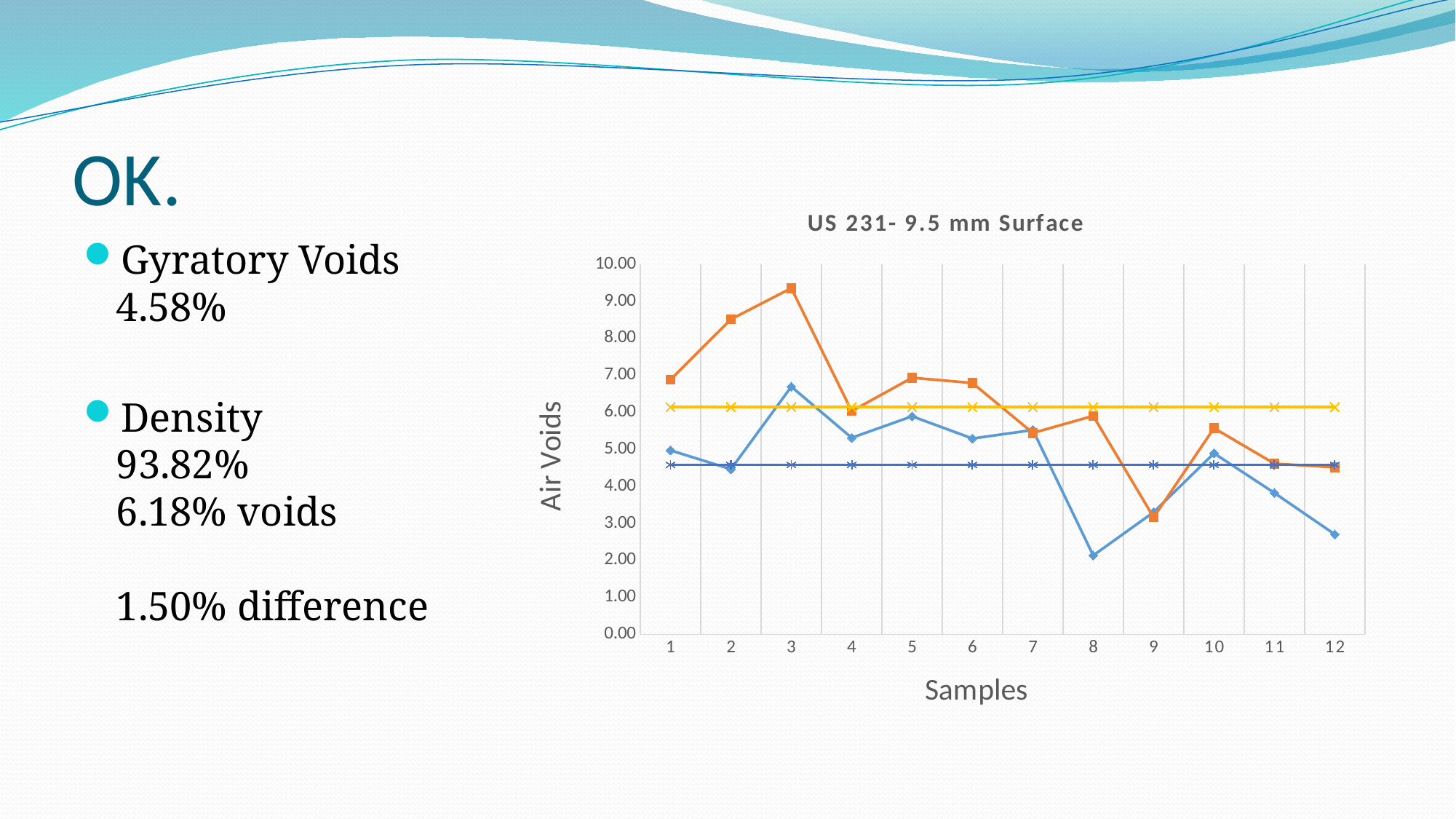
Is the flat dark blue asterisk-marker line greater or less than 5.00? less What is the title of the chart? US 231- 9.5 mm Surface What is the label on the vertical axis of the chart? Air Voids Is the value of the blue diamond-marker line at sample 8 greater or less than 3.00? less What kind of chart is shown on the slide? line chart How many samples are shown along the x axis of the chart? 12 At sample 8, which line has the higher value: the orange square-marker line or the blue diamond-marker line? orange square-marker line At which sample does the orange square-marker line reach its highest value? 3 Does the blue diamond-marker line rise or fall from sample 10 to sample 12? fall At which sample does the orange square-marker line reach its lowest value? 9 At which sample does the blue diamond-marker line reach its lowest value? 8 Is the value of the orange square-marker line at sample 3 greater or less than 9.00? greater